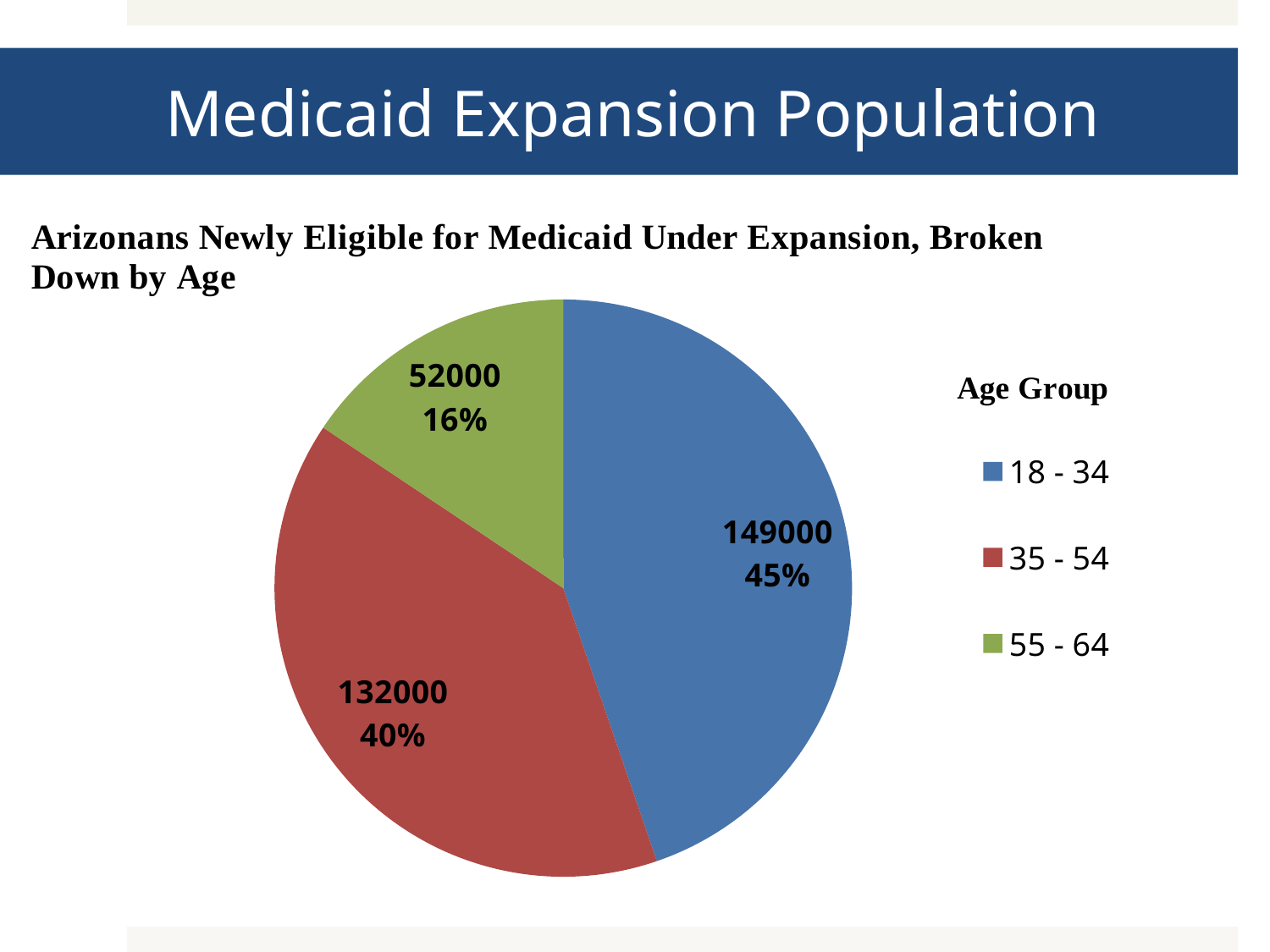
Which is larger, the value for 35 - 54 or the value for 55 - 64? 35 - 54 What is the value for the 55 - 64 age group? 52000 How many age groups are shown in the pie chart? 3 What share of the pie does the 55 - 64 age group represent? 16% What is the difference between the values for the 18 - 34 and 35 - 54 age groups? 17000 Which age group has the smallest share of the pie? 55 - 64 What share of the pie does the 35 - 54 age group represent? 40% What is the value for the 18 - 34 age group? 149000 What is the title of the legend in the pie chart? Age Group What is the value for the 35 - 54 age group? 132000 What type of chart is shown on the slide? pie chart Which age group has the largest share of the pie? 18 - 34